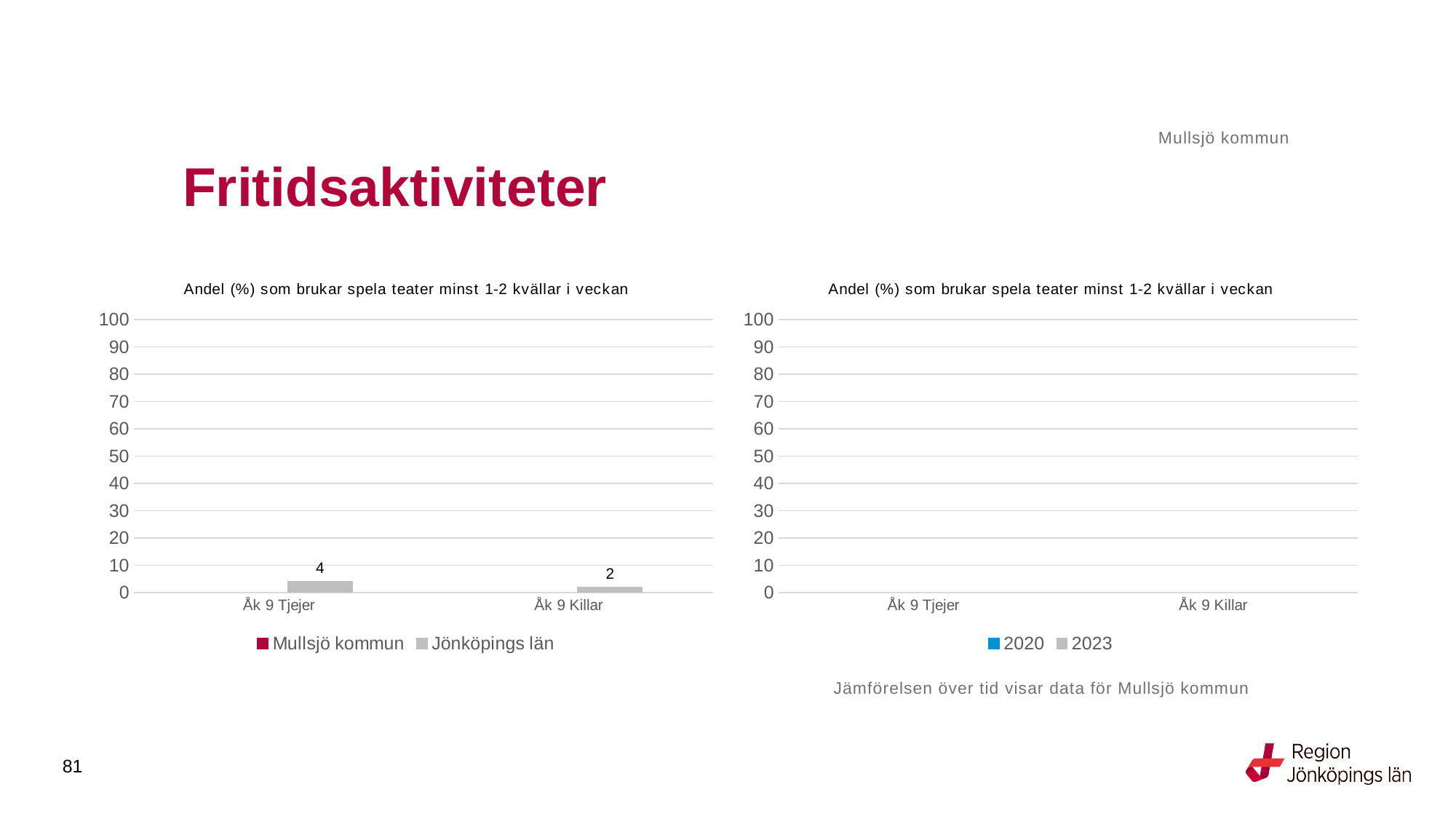
In the left chart, is the Jönköpings län value for Åk 9 Tjejer greater or less than 10? less What kind of chart is the left chart? bar chart How many series does the legend of the left chart list? 2 What is the title of the right chart? Andel (%) som brukar spela teater minst 1-2 kvällar i veckan In the left chart, what is the value for Jönköpings län for Åk 9 Killar? 2 How many categories are shown on the x axis of the left chart? 2 Which years are listed in the legend of the right chart? 2020 and 2023 In the left chart, what is the difference between the Jönköpings län values for Åk 9 Tjejer and Åk 9 Killar? 2 In the left chart, what is the value for Jönköpings län for Åk 9 Tjejer? 4 In the left chart, which category has the higher Jönköpings län value? Åk 9 Tjejer How many series does the legend of the right chart list? 2 In the left chart, which category has the lower Jönköpings län value? Åk 9 Killar